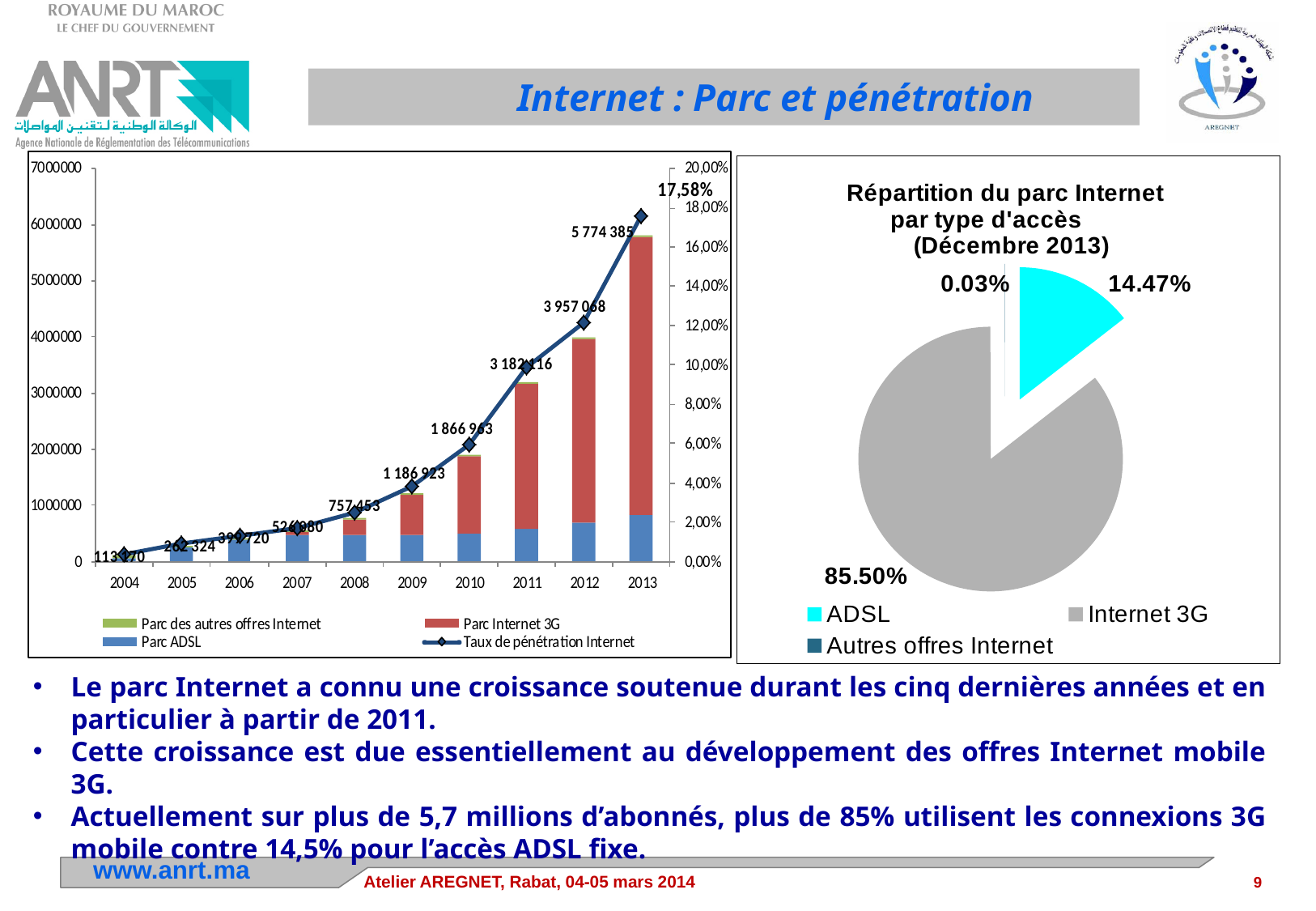
In the pie chart 'Répartition du parc Internet par type d'accès', what share does ADSL have? 14.47% In the left chart, how many series does the legend list? 4 In the pie chart 'Répartition du parc Internet par type d'accès', what share does Internet 3G have? 85.50% In the left chart, do the bar values rise or fall from 2004 to 2013? rise In the left chart, what is the difference between the labelled values for 2013 and 2012? 1 817 317 What kind of chart is the right-hand chart 'Répartition du parc Internet par type d'accès'? pie chart In the left chart, what is the total Internet subscriber base (parc) labelled for 2013? 5 774 385 In the left chart, what value is labelled for 2012? 3 957 068 In the left chart, how many years are shown on the x axis? 10 In the left chart, what is the Internet penetration rate (Taux de pénétration Internet) shown for 2013? 17,58% In the pie chart 'Répartition du parc Internet par type d'accès', which access type has the smallest share? Autres offres Internet In the left chart, what value is labelled for 2009? 1 186 923